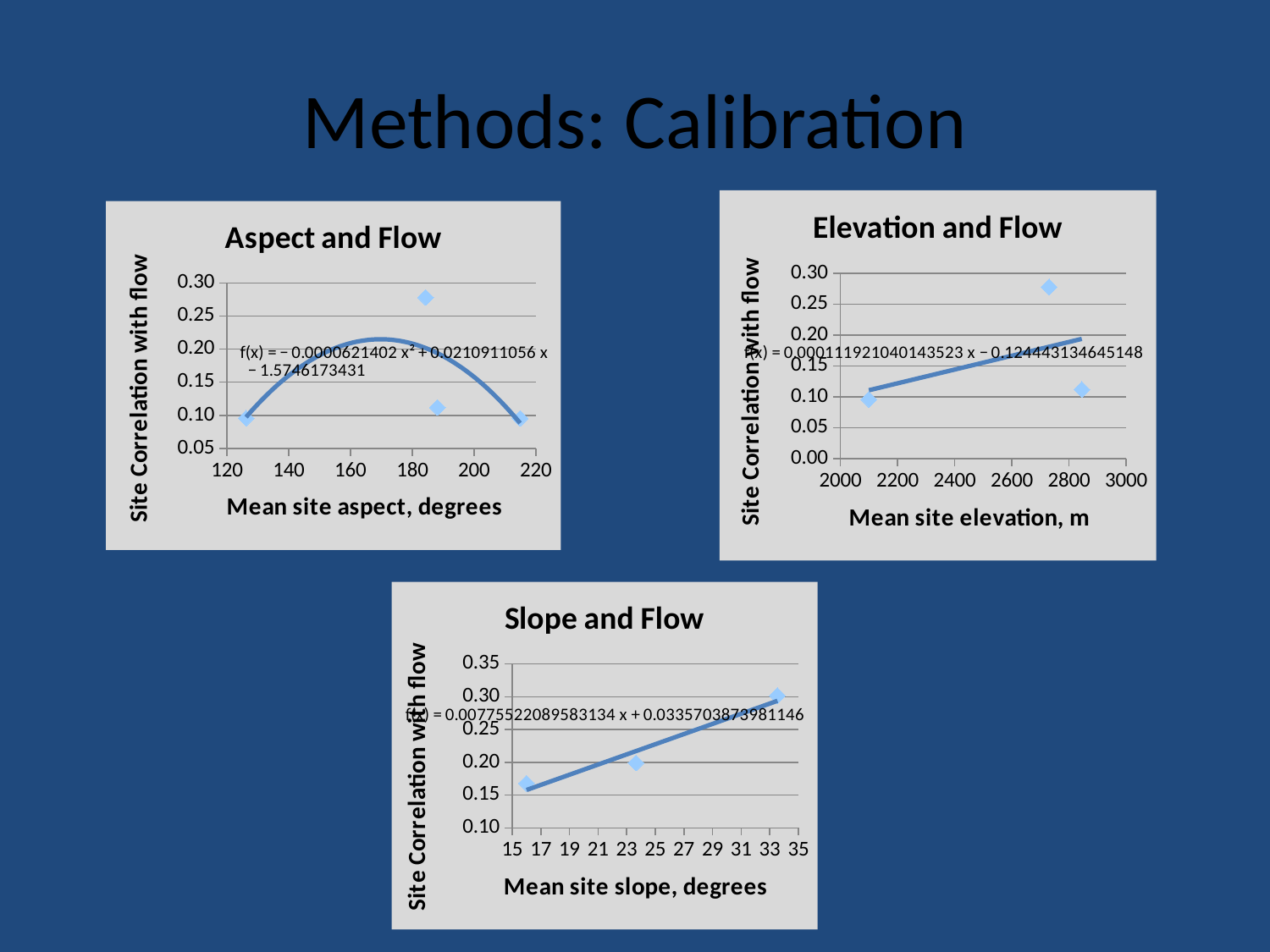
In the 'Aspect and Flow' chart, is the highest plotted site correlation greater or less than 0.25? greater What is the y-axis label of the 'Elevation and Flow' chart? Site Correlation with flow What kind of chart is the 'Slope and Flow' chart? scatter chart In the 'Elevation and Flow' chart, does the fitted trendline rise or fall as mean site elevation increases? rise In the 'Slope and Flow' chart, is the site correlation for the point at the highest slope greater or less than 0.25? greater In the 'Slope and Flow' chart, is the site correlation for the point at the lowest slope greater or less than 0.20? less How many data points are plotted in the 'Aspect and Flow' chart? 4 How many data points are plotted in the 'Slope and Flow' chart? 3 In the 'Slope and Flow' chart, does the fitted trendline rise or fall as mean site slope increases? rise What is the x-axis label of the 'Slope and Flow' chart? Mean site slope, degrees How many data points are plotted in the 'Elevation and Flow' chart? 3